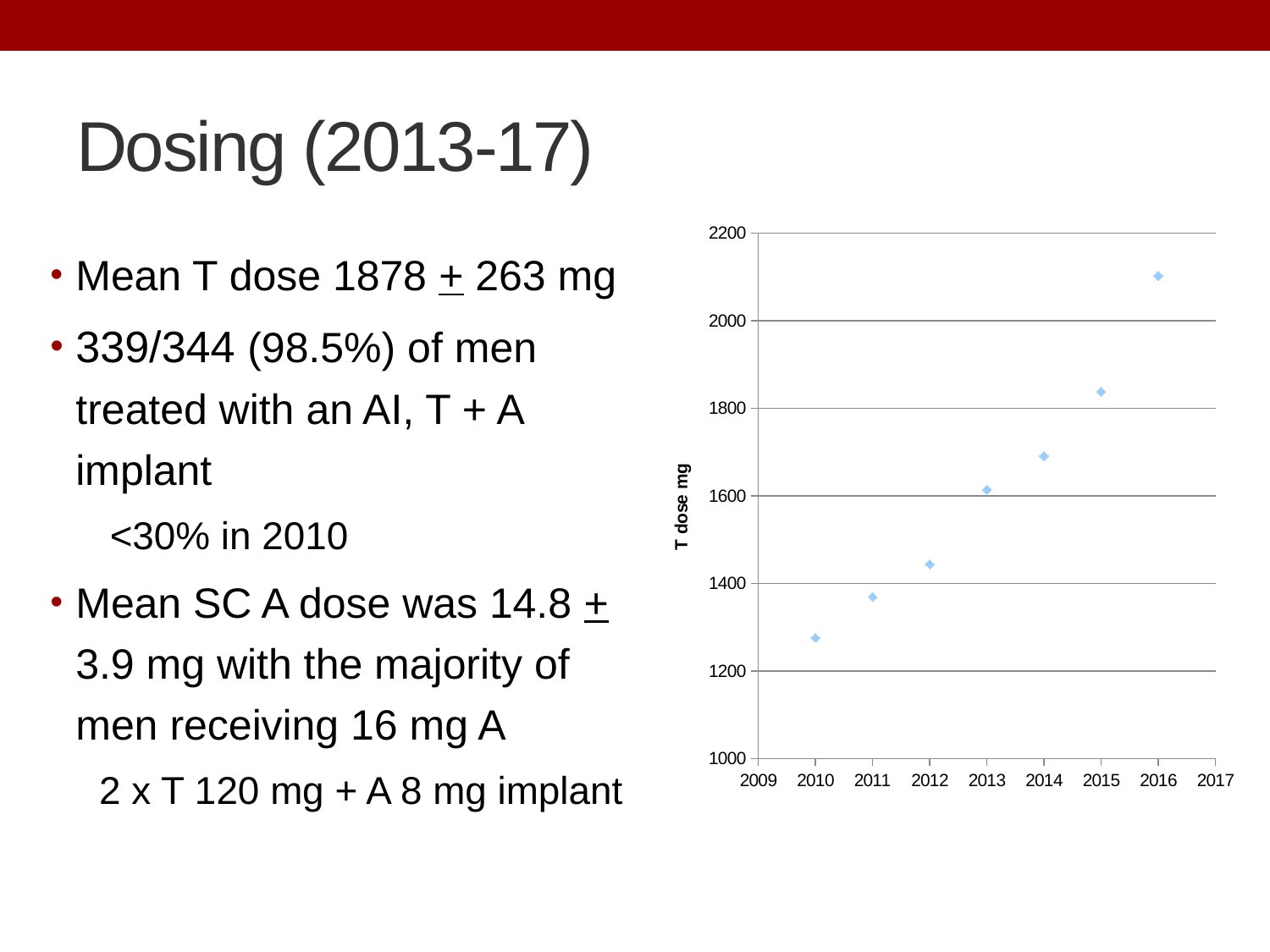
Do the T dose values rise or fall from 2010 to 2016? rise Is the value for 2012 greater or less than 1400? greater Is the value for 2014 greater or less than 1800? less Is the value for 2016 greater or less than 2000? greater Which year has the lowest T dose on the chart? 2010 What is the label on the vertical axis of the chart? T dose mg Which year has the highest T dose on the chart? 2016 What kind of chart is shown on the slide? scatter chart Which year has the larger T dose, 2012 or 2015? 2015 How many data points are plotted on the chart? 7